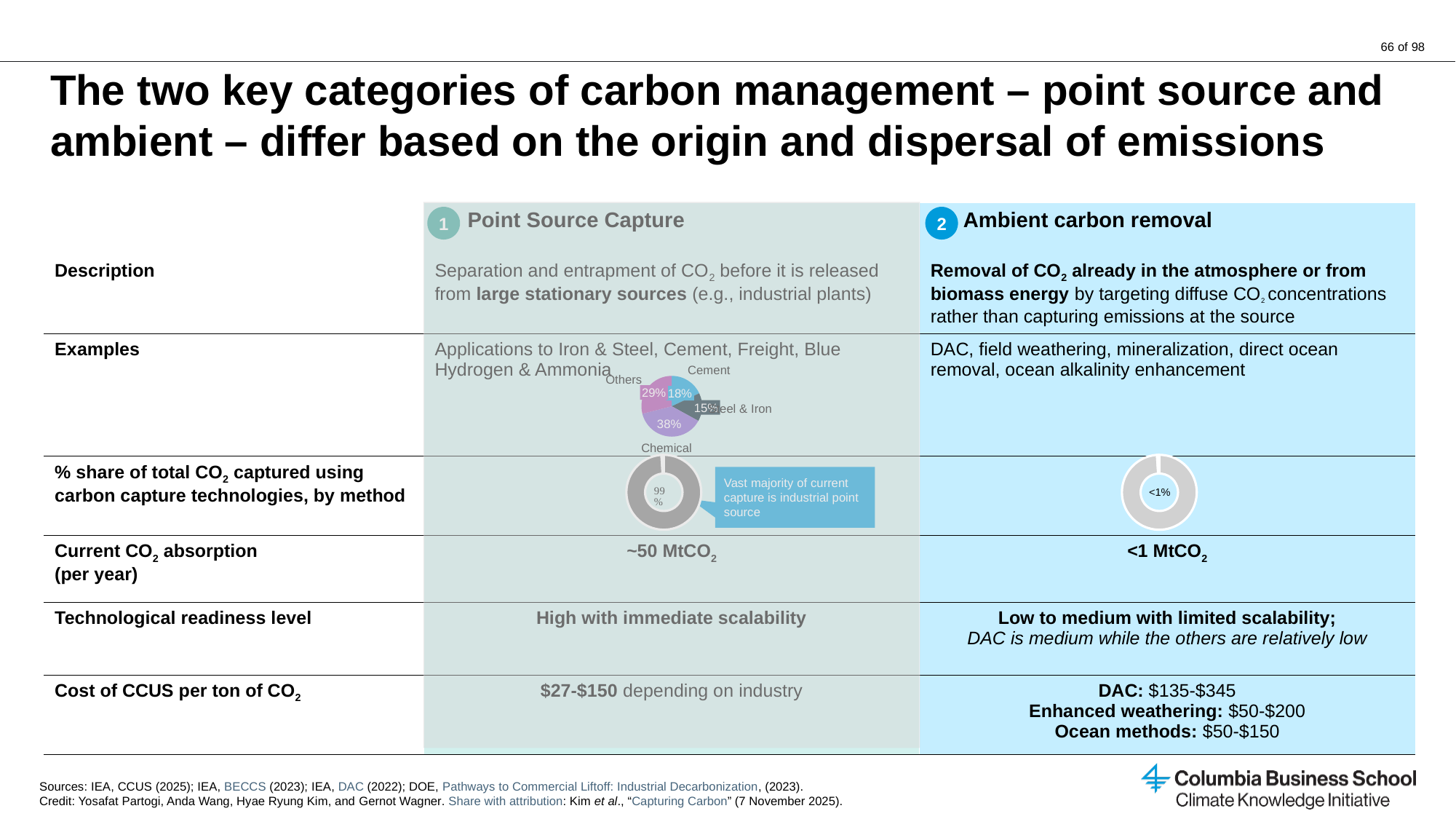
In the pie chart under Point Source Capture, what share is shown for Cement? 18% In the pie chart under Point Source Capture, what is the difference between the Chemical share and the Cement share? 20 percentage points In the pie chart under Point Source Capture, what share is shown for Chemical? 38% In the pie chart under Point Source Capture, which is larger: Others or Cement? Others How many categories does the pie chart under Point Source Capture show? 4 In the pie chart under Point Source Capture, which category has the smallest share? Steel & Iron In the pie chart under Point Source Capture, what share is shown for Others? 29% In the pie chart under Point Source Capture, which category has the largest share? Chemical What kind of chart is shown under the Examples row for Point Source Capture? Pie chart In the donut chart in the '% share of total CO2 captured' row under Point Source Capture, what value is shown? 99% In the donut chart in the '% share of total CO2 captured' row under Ambient carbon removal, what value is shown? <1% In the pie chart under Point Source Capture, what share is shown for Steel & Iron? 15%